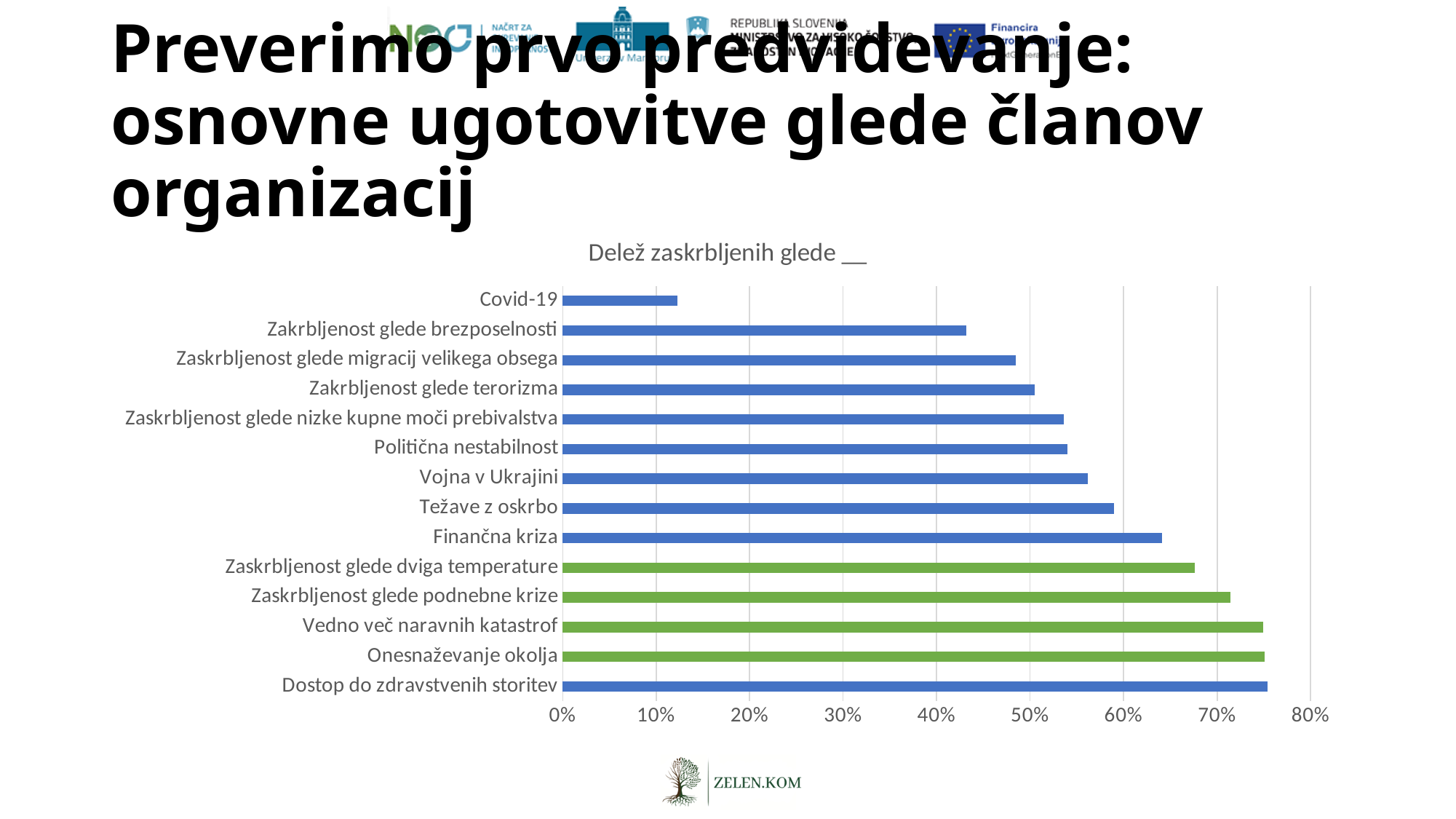
Is the value for Zakrbljenost glede brezposelnosti greater or less than 50%? less Which has a larger value: Zaskrbljenost glede podnebne krize or Zakrbljenost glede terorizma? Zaskrbljenost glede podnebne krize Which has a larger value: Finančna kriza or Covid-19? Finančna kriza Is the value for Zaskrbljenost glede dviga temperature greater or less than 60%? greater Is the value for Covid-19 greater or less than 20%? less What kind of chart is shown on the slide? bar chart What is the title of the chart? Delež zaskrbljenih glede __ Which category has the lowest value in the chart? Covid-19 How many categories are plotted in the chart? 14 How many bars in the chart are coloured green? 4